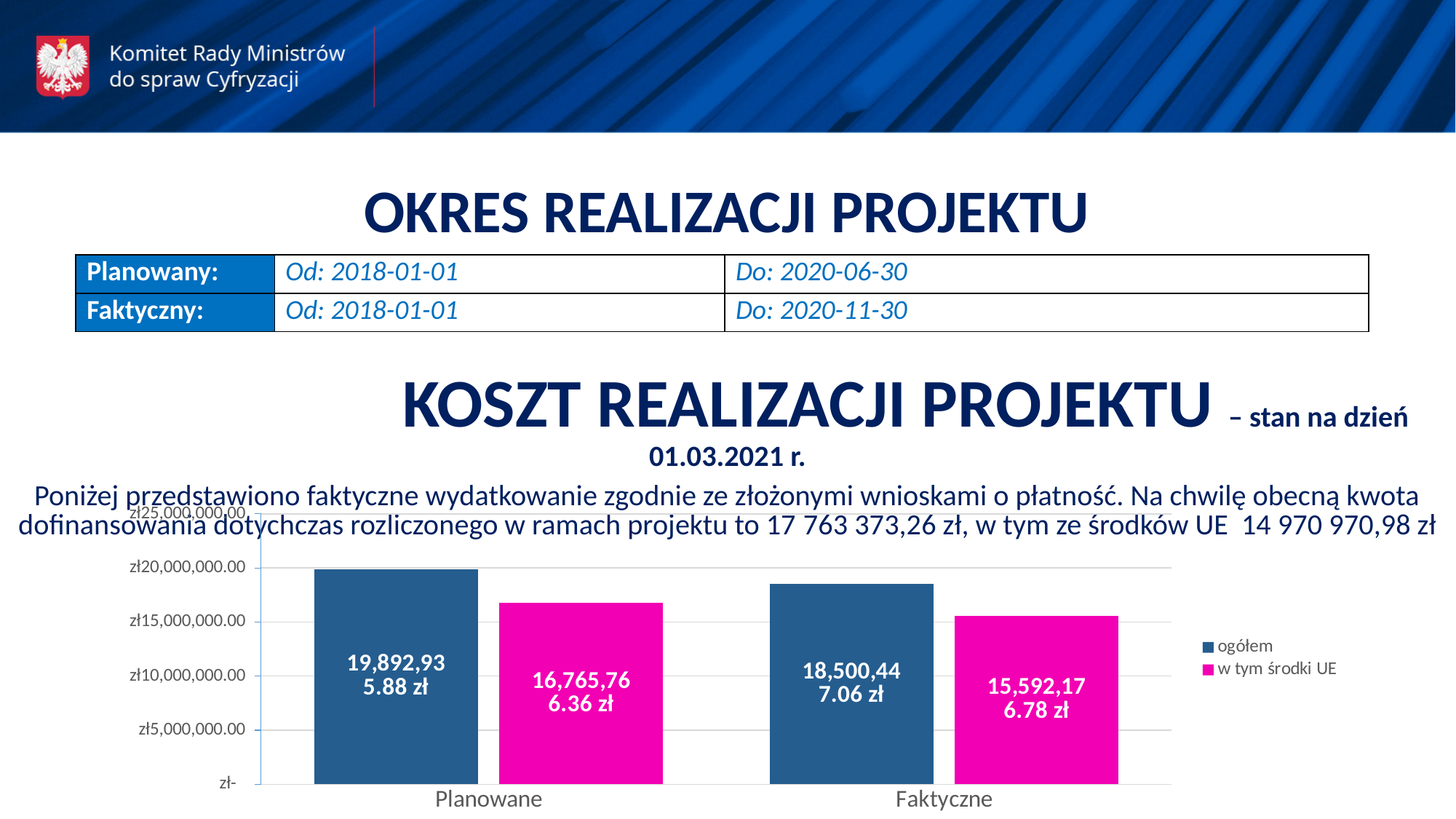
What is the value of the 'w tym środki UE' bar for Faktyczne? 15,592,176.78 zł What is the value of the 'ogółem' bar for Planowane? 19,892,935.88 zł What is the value of the 'w tym środki UE' bar for Planowane? 16,765,766.36 zł What is the value of the 'ogółem' bar for Faktyczne? 18,500,447.06 zł Which bar in the chart has the lowest value? w tym środki UE for Faktyczne Is the 'ogółem' value for Faktyczne greater or less than zł20,000,000.00? less How many series does the chart legend list? 2 Which is larger: the 'w tym środki UE' value for Planowane or for Faktyczne? Planowane What is the difference between the 'ogółem' values for Planowane and Faktyczne? 1,392,488.82 zł Which bar in the chart has the highest value? ogółem for Planowane What is the difference between the 'ogółem' and 'w tym środki UE' values for Planowane? 3,127,169.52 zł What type of chart is shown on the slide? bar chart